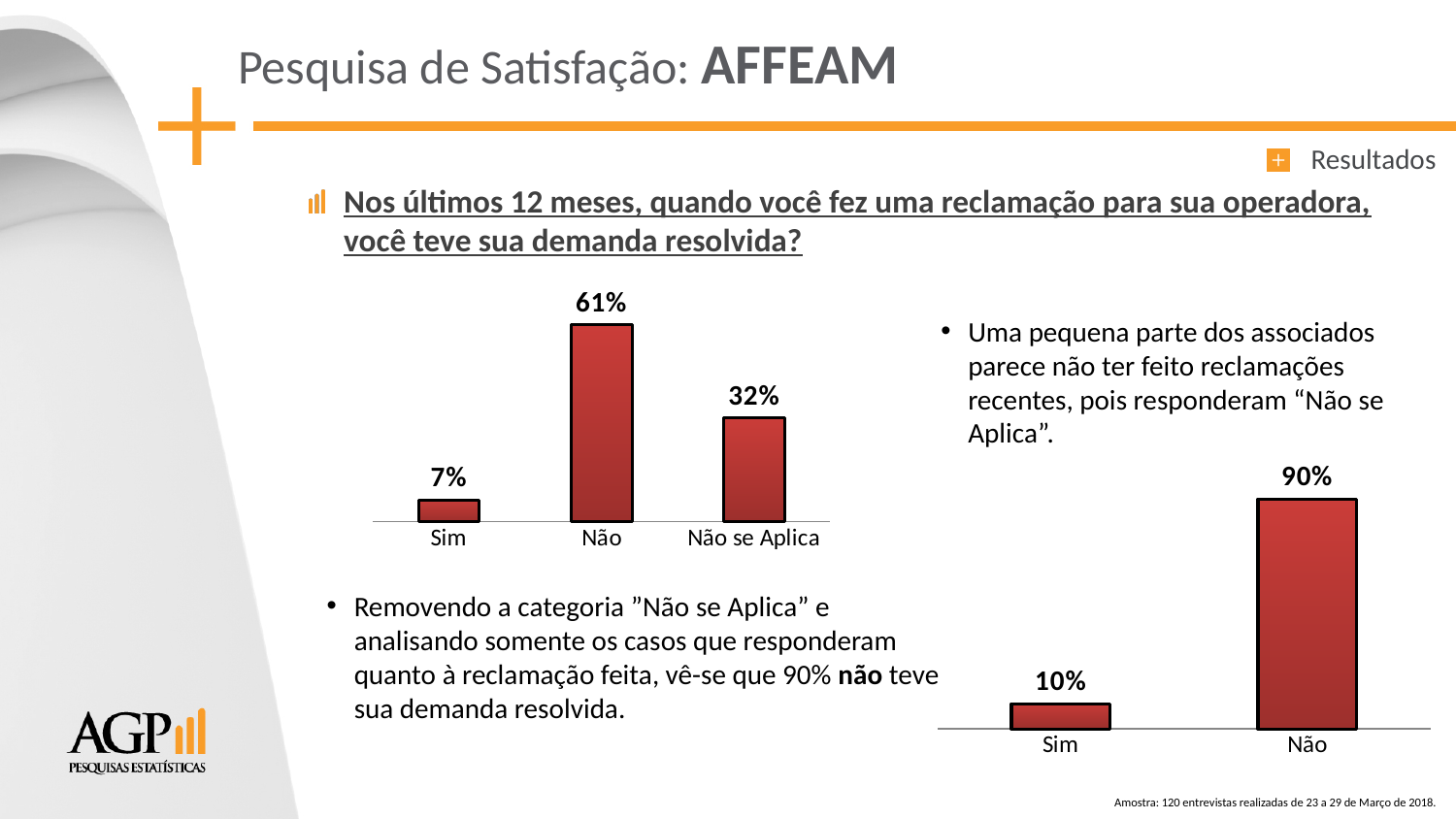
In the right chart, what is the difference between the values for "Não" and "Sim"? 80% In the right chart, what is the value for "Não"? 90% In the right chart, what is the value for "Sim"? 10% What kind of chart is the right chart? Bar chart In the left chart, how many categories are shown? 3 In the right chart, which is larger, "Sim" or "Não"? Não In the left chart, which category has the lowest value? Sim In the left chart, what is the value for "Não se Aplica"? 32% In the left chart, what is the value for "Não"? 61% In the left chart, what is the value for "Sim"? 7% In the left chart, which category has the highest value? Não In the left chart, what is the difference between the values for "Não" and "Não se Aplica"? 29%